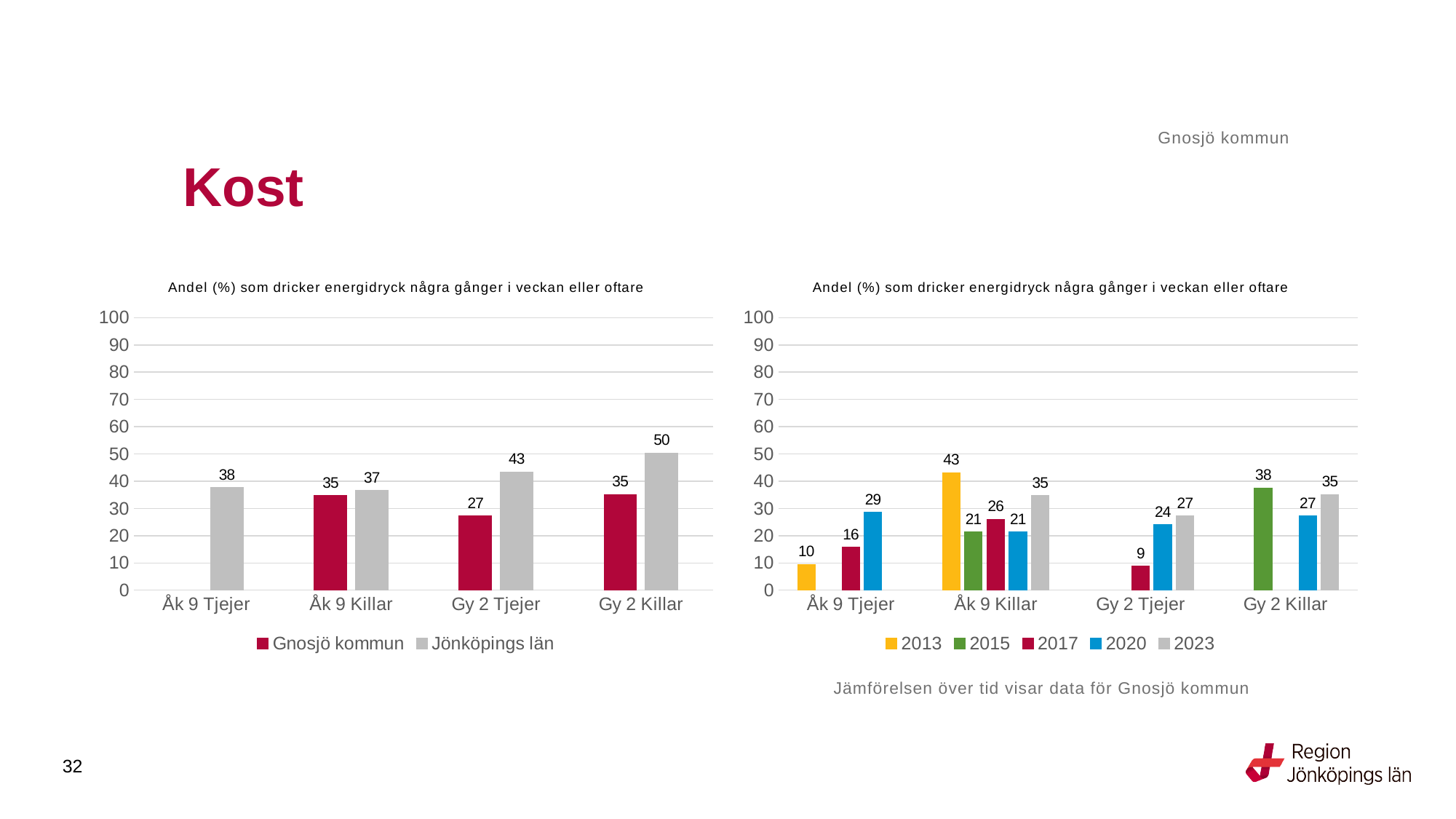
In the right chart, what is the difference between the 2020 and 2017 values for Gy 2 Tjejer? 15 How many series does the legend of the left chart list? 2 In the left chart, which is larger for Åk 9 Killar: Gnosjö kommun or Jönköpings län? Jönköpings län In the left chart, which category has the highest value for Jönköpings län? Gy 2 Killar In the left chart, what is the value for Gnosjö kommun for Gy 2 Tjejer? 27 In the right chart, what is the value for 2013 for Åk 9 Killar? 43 In the left chart, what is the value for Jönköpings län for Gy 2 Killar? 50 In the right chart, what is the value for 2023 for Gy 2 Tjejer? 27 In the right chart, which year has the lowest value for Åk 9 Tjejer? 2013 What kind of chart is the right chart? Bar chart In the left chart, what is the difference between Jönköpings län and Gnosjö kommun for Gy 2 Killar? 15 How many series does the legend of the right chart list? 5